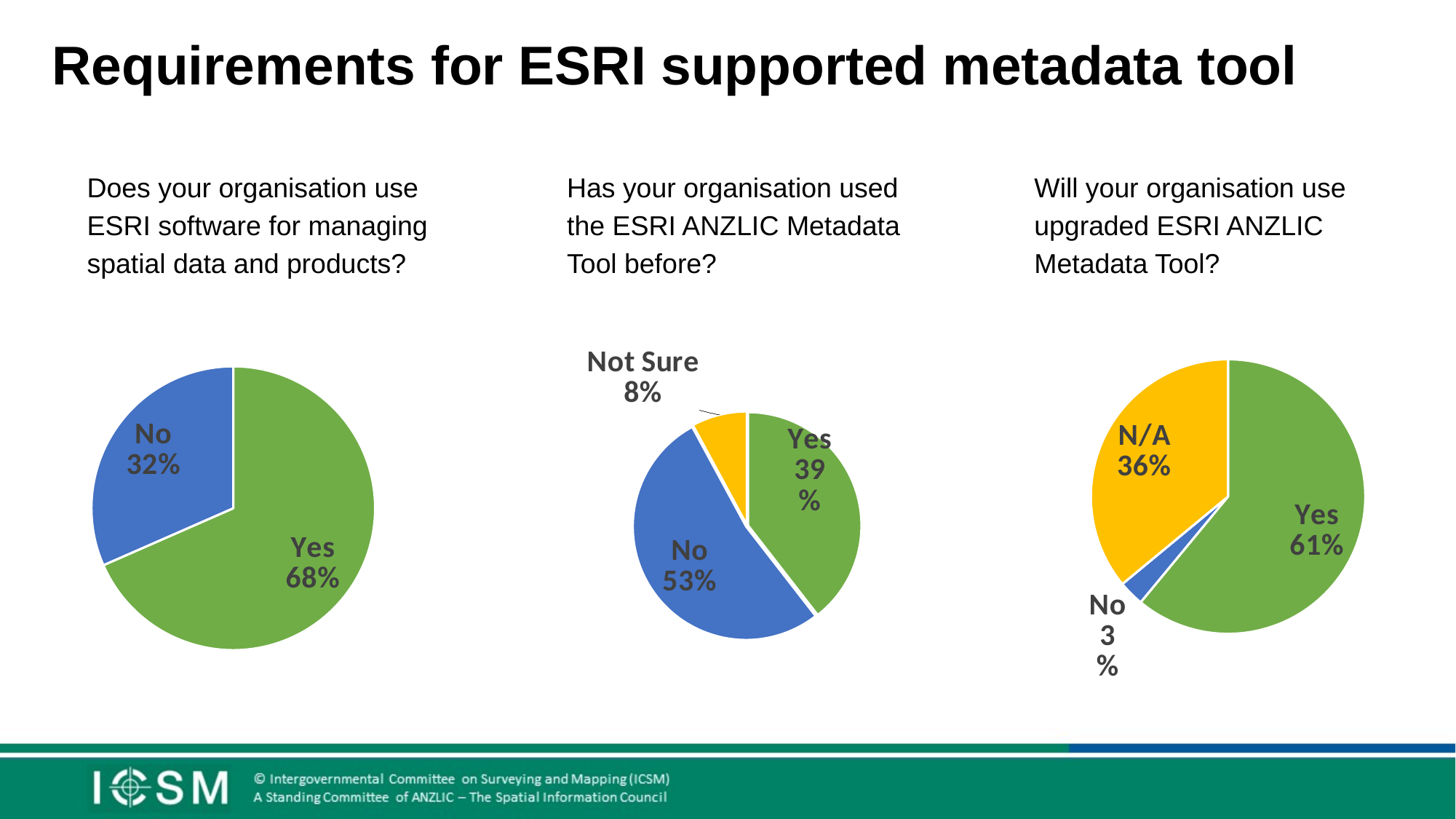
In the middle pie chart (Has your organisation used the ESRI ANZLIC Metadata Tool before?), what is the difference in percentage points between No and Yes? 14 In the left pie chart (Does your organisation use ESRI software for managing spatial data and products?), what share of responses is No? 32% In the right pie chart (Will your organisation use upgraded ESRI ANZLIC Metadata Tool?), which is larger, Yes or N/A? Yes In the right pie chart (Will your organisation use upgraded ESRI ANZLIC Metadata Tool?), what share of responses is N/A? 36% In the middle pie chart (Has your organisation used the ESRI ANZLIC Metadata Tool before?), which response has the smallest share? Not Sure How many slices does the middle pie chart (Has your organisation used the ESRI ANZLIC Metadata Tool before?) have? 3 In the left pie chart (Does your organisation use ESRI software for managing spatial data and products?), what share of responses is Yes? 68% In the middle pie chart (Has your organisation used the ESRI ANZLIC Metadata Tool before?), what share of responses is Not Sure? 8% How many pie charts are shown on the slide? 3 In the middle pie chart (Has your organisation used the ESRI ANZLIC Metadata Tool before?), which response has the largest share? No In the right pie chart (Will your organisation use upgraded ESRI ANZLIC Metadata Tool?), which response has the smallest share? No What type of chart is used for the left chart (Does your organisation use ESRI software for managing spatial data and products?)? Pie chart